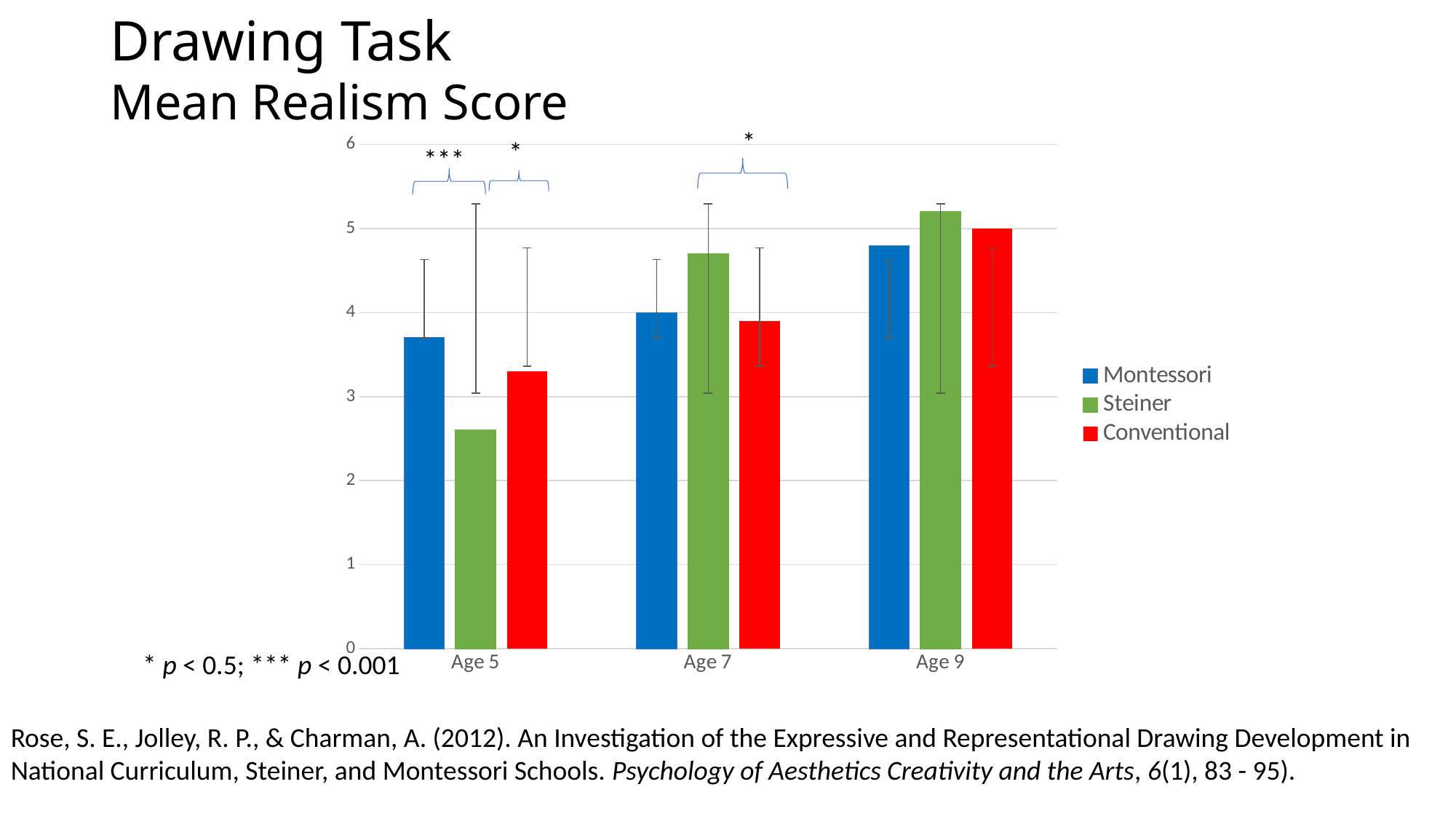
How many age groups are shown on the x axis? 3 Which series has the highest mean realism score at Age 7? Steiner Is the Steiner value at Age 5 greater or less than 3? less Is the Steiner value at Age 7 greater or less than 4? greater Which colour represents the Conventional series in the legend? red Which series has the lowest mean realism score at Age 5? Steiner Which series has the highest mean realism score at Age 9? Steiner At Age 5, which is larger: the Montessori value or the Conventional value? Montessori What kind of chart is shown on the slide? bar chart How many series does the legend list? 3 Do the Montessori values rise or fall from Age 5 to Age 9? rise Is the Montessori value at Age 5 greater or less than 3? greater